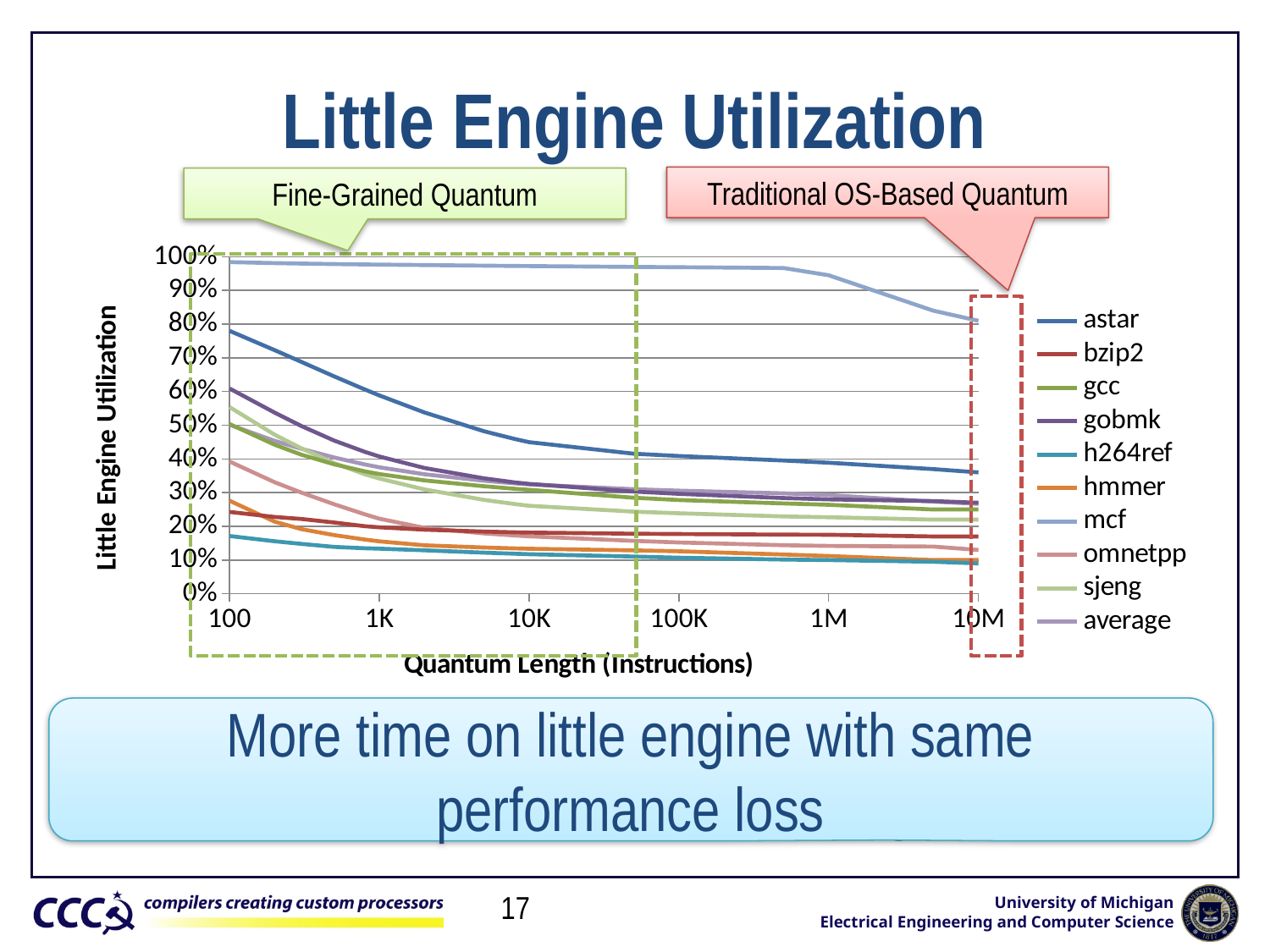
What kind of chart is shown on the slide? line chart Does the utilization for astar rise or fall as quantum length increases? fall At a quantum length of 10M, which is larger, the value for bzip2 or the value for hmmer? bzip2 Is the value for astar at a quantum length of 100 greater or less than 70%? greater Which series has the highest little engine utilization at a quantum length of 100? mcf Is the value for mcf at a quantum length of 1K greater or less than 90%? greater At a quantum length of 100, which is larger, the value for astar or the value for gobmk? astar How many quantum length values are labelled on the x axis? 6 What is the title of the x axis of the chart? Quantum Length (Instructions) How many series does the legend list? 10 Which series has the lowest little engine utilization at a quantum length of 100? h264ref Is the value for h264ref at a quantum length of 10M greater or less than 20%? less